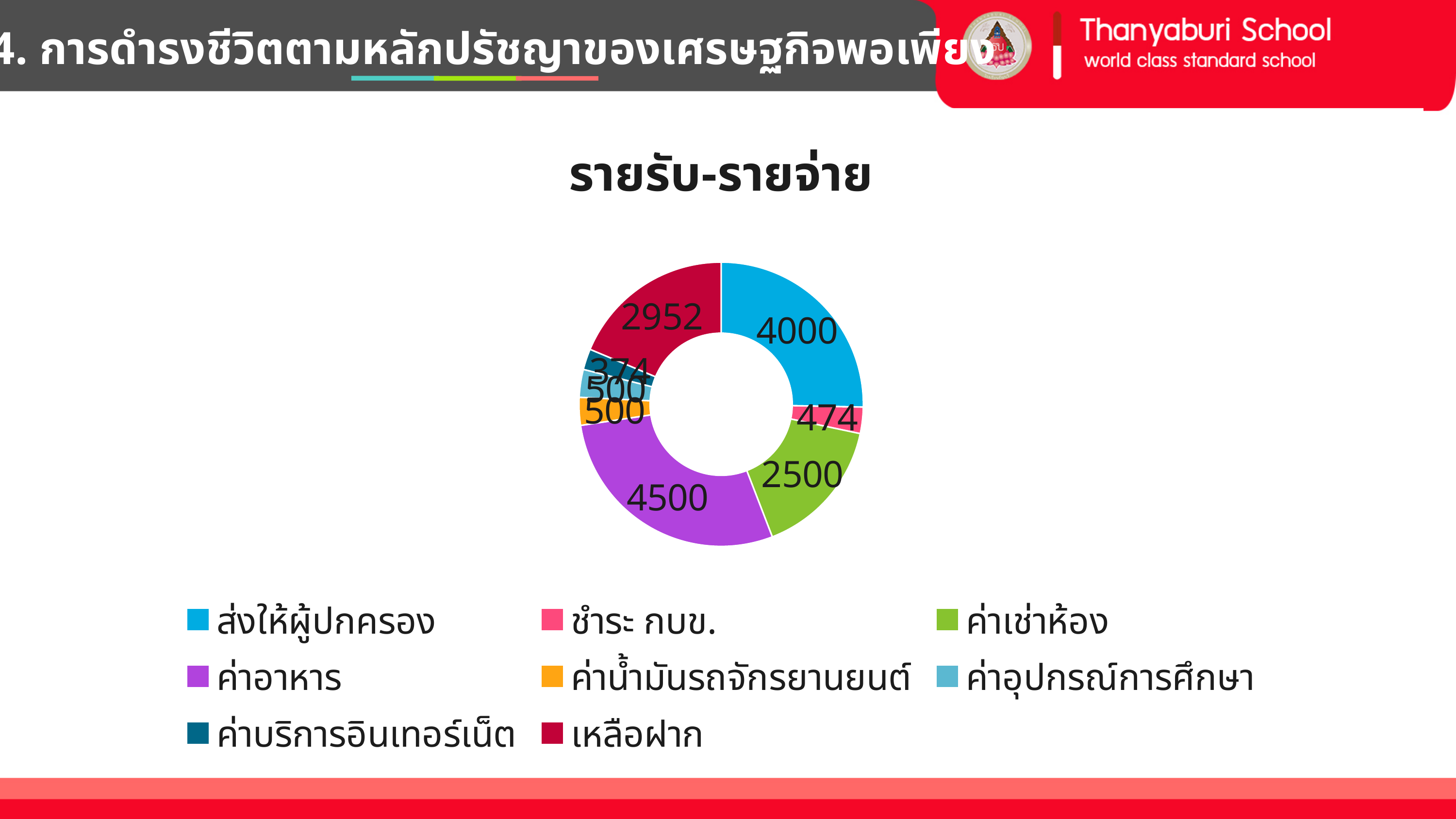
What is the title of the chart? รายรับ-รายจ่าย What is the value for ค่าเช่าห้อง? 2500 What kind of chart is shown on the slide? Doughnut (pie) chart What is the value for ส่งให้ผู้ปกครอง? 4000 How many categories does the chart show? 8 What is the value for ค่าอาหาร? 4500 What is the difference between the values for ค่าอาหาร and ส่งให้ผู้ปกครอง? 500 Which category has the largest value? ค่าอาหาร What is the value for ค่าบริการอินเทอร์เน็ต? 374 What is the value for เหลือฝาก? 2952 Which category has the smallest value? ค่าบริการอินเทอร์เน็ต What is the value for ชำระ กบข.? 474